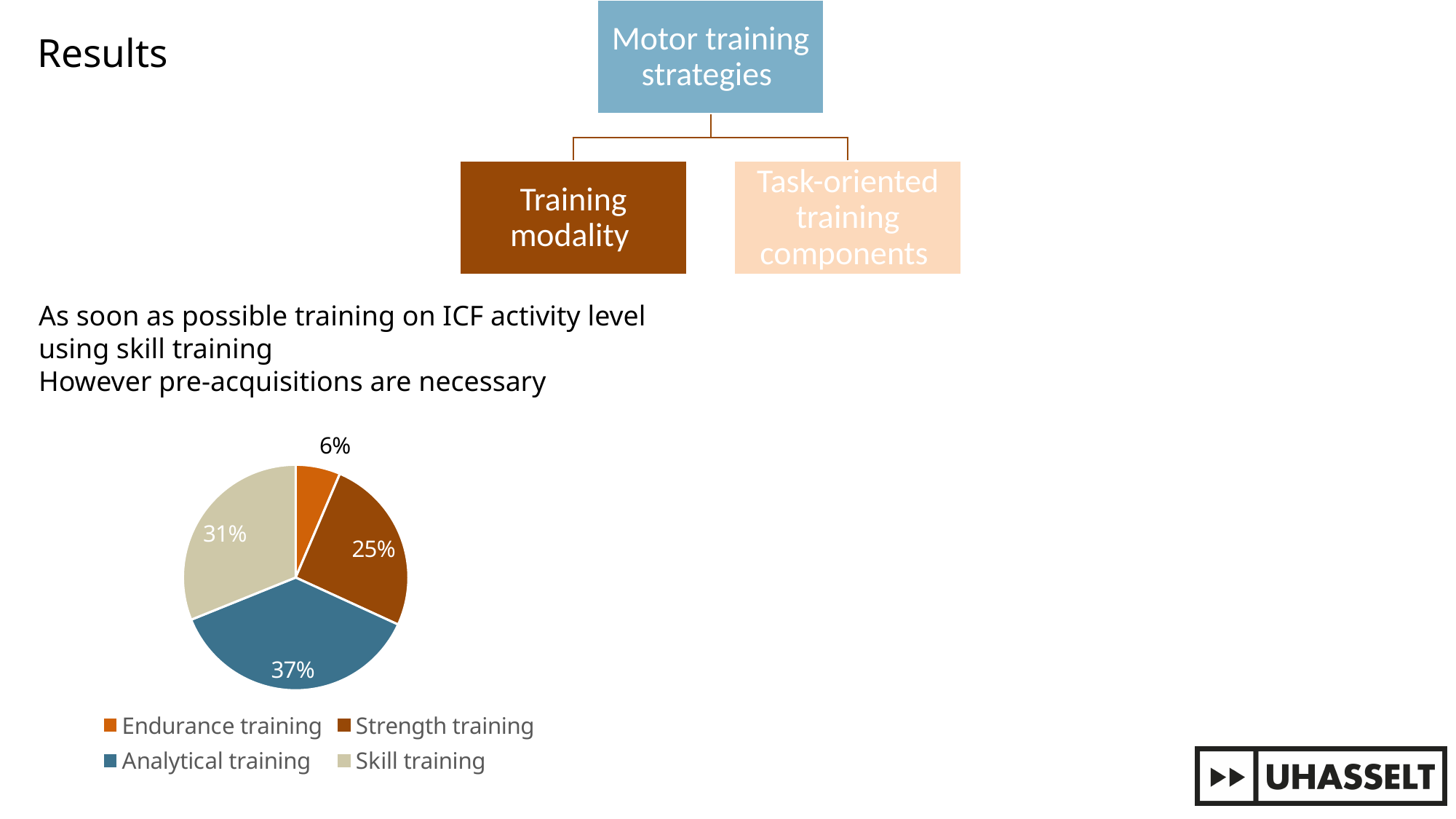
What is the difference in percentage points between Analytical training and Strength training? 12 What share of the pie does Skill training have? 31% Which training modality has the largest slice of the pie? Analytical training What share of the pie does Strength training have? 25% Which training modality has the smallest slice of the pie? Endurance training What share of the pie does Endurance training have? 6% Which colour represents Analytical training in the pie chart? blue What kind of chart is shown on the slide? pie chart Which is larger, the share for Skill training or the share for Strength training? Skill training What share of the pie does Analytical training have? 37% What is the difference in percentage points between Skill training and Endurance training? 25 How many slices does the pie chart have? 4